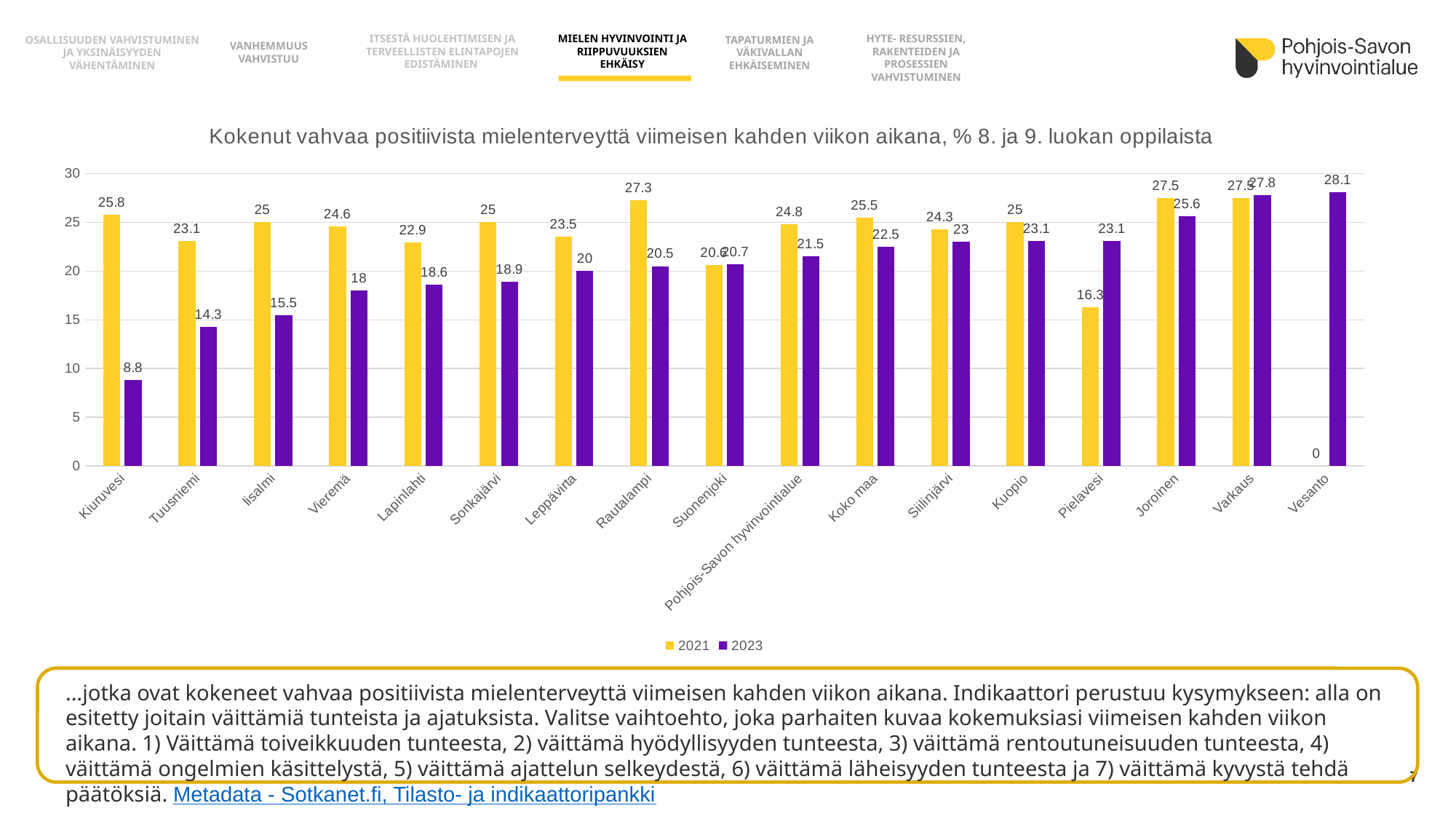
How many series does the legend list? 2 For Pielavesi, which series has the larger value, 2021 or 2023? 2023 What kind of chart is shown on the slide? bar chart What is the 2021 value for Rautalampi? 27.3 Which category has the lowest 2023 value? Kiuruvesi How many categories are shown on the x axis? 17 What is the 2023 value for Koko maa? 22.5 Is the 2023 value for Tuusniemi greater or less than 15? less What is the difference between the 2021 and 2023 values for Kiuruvesi? 17 Which category has the highest 2023 value? Vesanto Which category has the lowest 2021 value? Vesanto What is the 2023 value for Kiuruvesi? 8.8